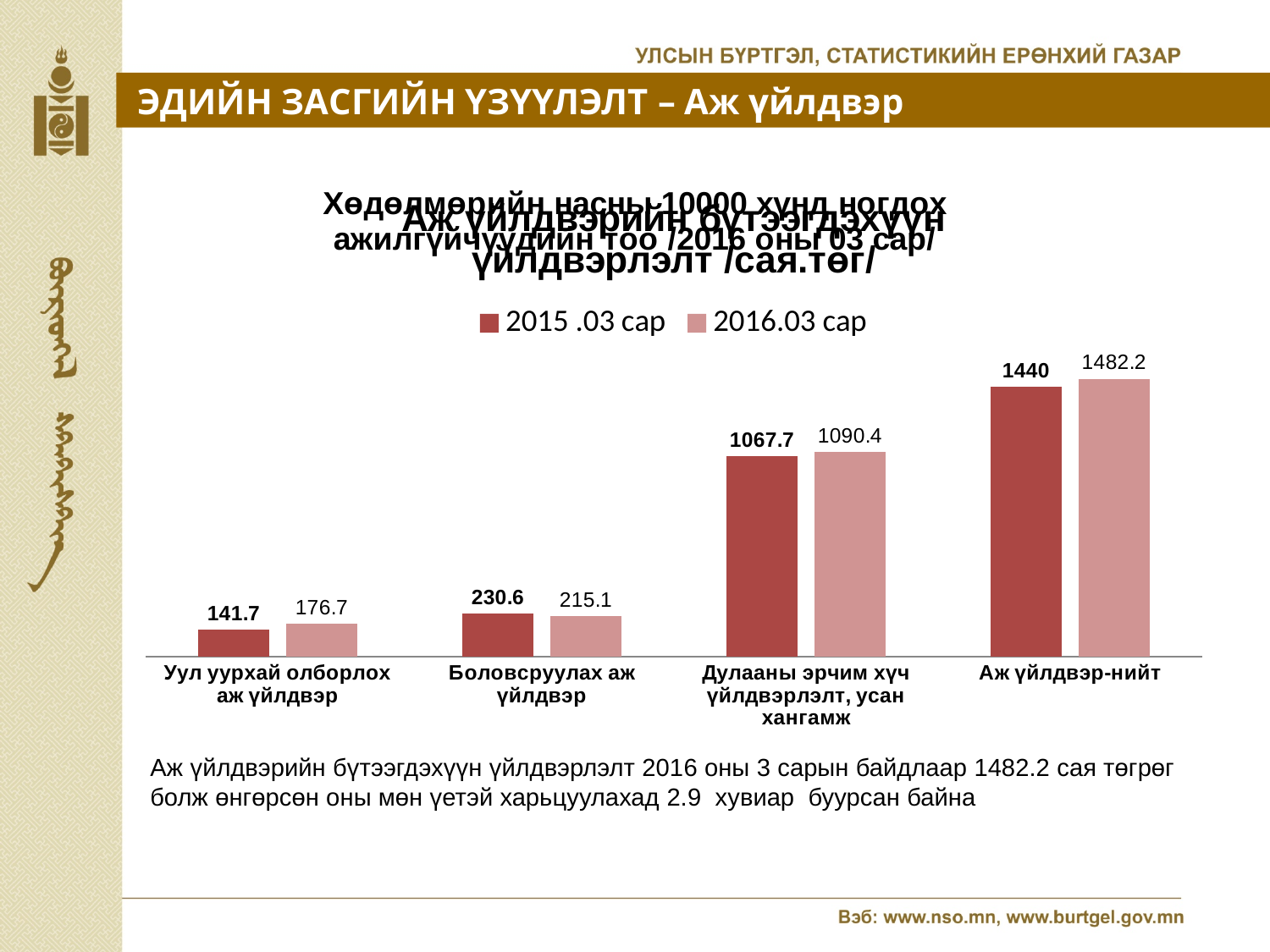
How many categories are shown on the x axis of the chart? 4 What kind of chart is shown on the slide? Bar chart For Боловсруулах аж үйлдвэр, which is larger: the 2015 .03 сар value or the 2016.03 сар value? 2015 .03 сар What is the difference between the 2016.03 сар and 2015 .03 сар values for Аж үйлдвэр-нийт? 42.2 Which category has the lowest value in the 2015 .03 сар series? Уул уурхай олборлох аж үйлдвэр What is the 2015 .03 сар value for Дулааны эрчим хүч үйлдвэрлэлт, усан хангамж? 1067.7 What is the difference between the 2015 .03 сар and 2016.03 сар values for Боловсруулах аж үйлдвэр? 15.5 Which category has the highest value in the 2016.03 сар series? Аж үйлдвэр-нийт What is the value for Уул уурхай олборлох аж үйлдвэр in the 2016.03 сар series? 176.7 How many series does the chart legend list? 2 What is the 2016.03 сар value for Аж үйлдвэр-нийт? 1482.2 What is the value for Боловсруулах аж үйлдвэр in the 2015 .03 сар series? 230.6